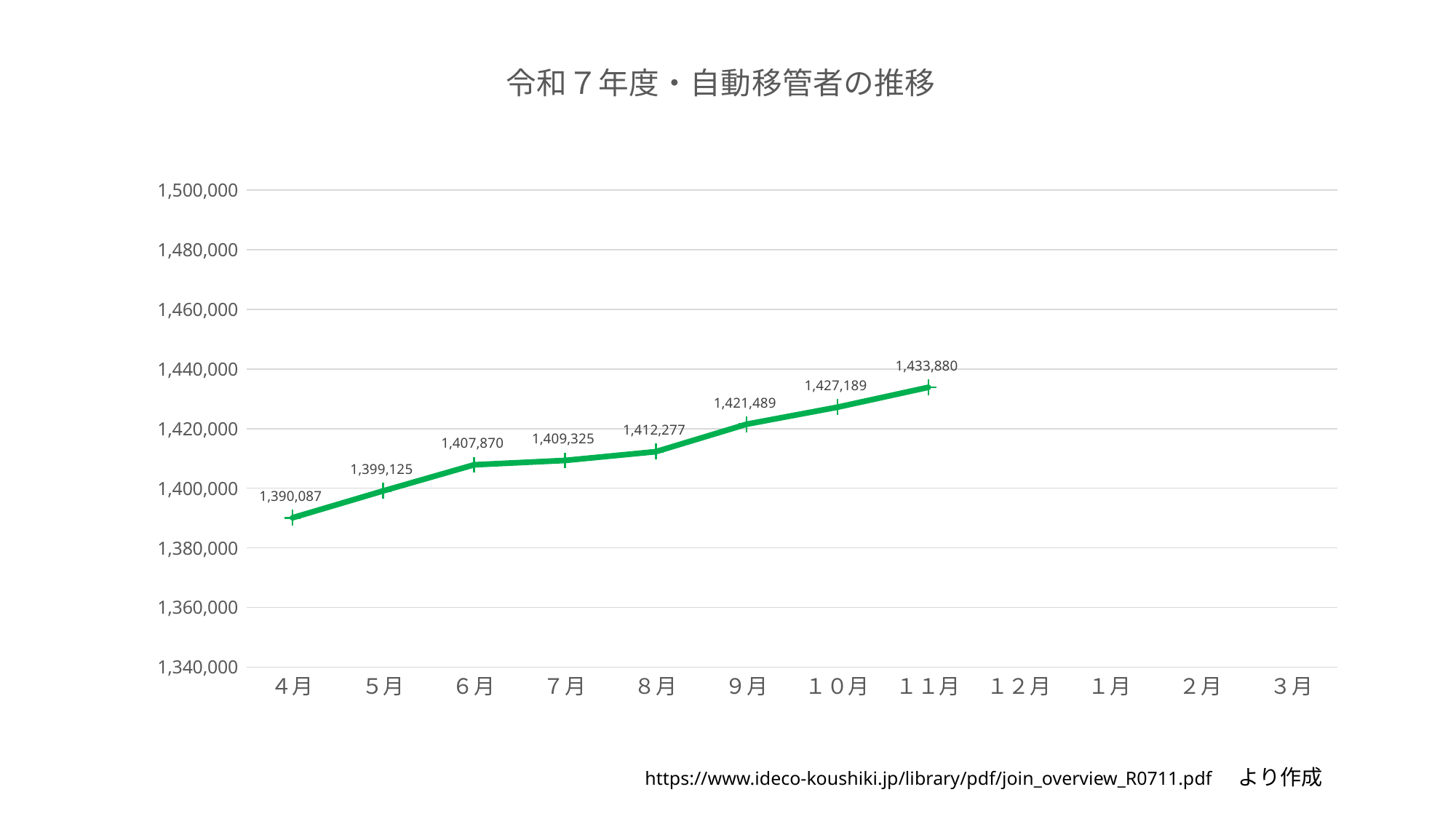
What is the value for 11月? 1,433,880 What is the difference between the values for 9月 and 8月? 9,212 What kind of chart is this? line chart Which month has the lowest plotted value? 4月 What is the value for 4月? 1,390,087 What is the value for 8月? 1,412,277 Is the value for 9月 greater or less than 1,420,000? greater Do the values rise or fall from 4月 to 11月? rise Which month has the highest plotted value? 11月 Which is larger, the value for 6月 or the value for 10月? 10月 What is the difference between the values for 11月 and 4月? 43,793 How many months have a plotted data point? 8